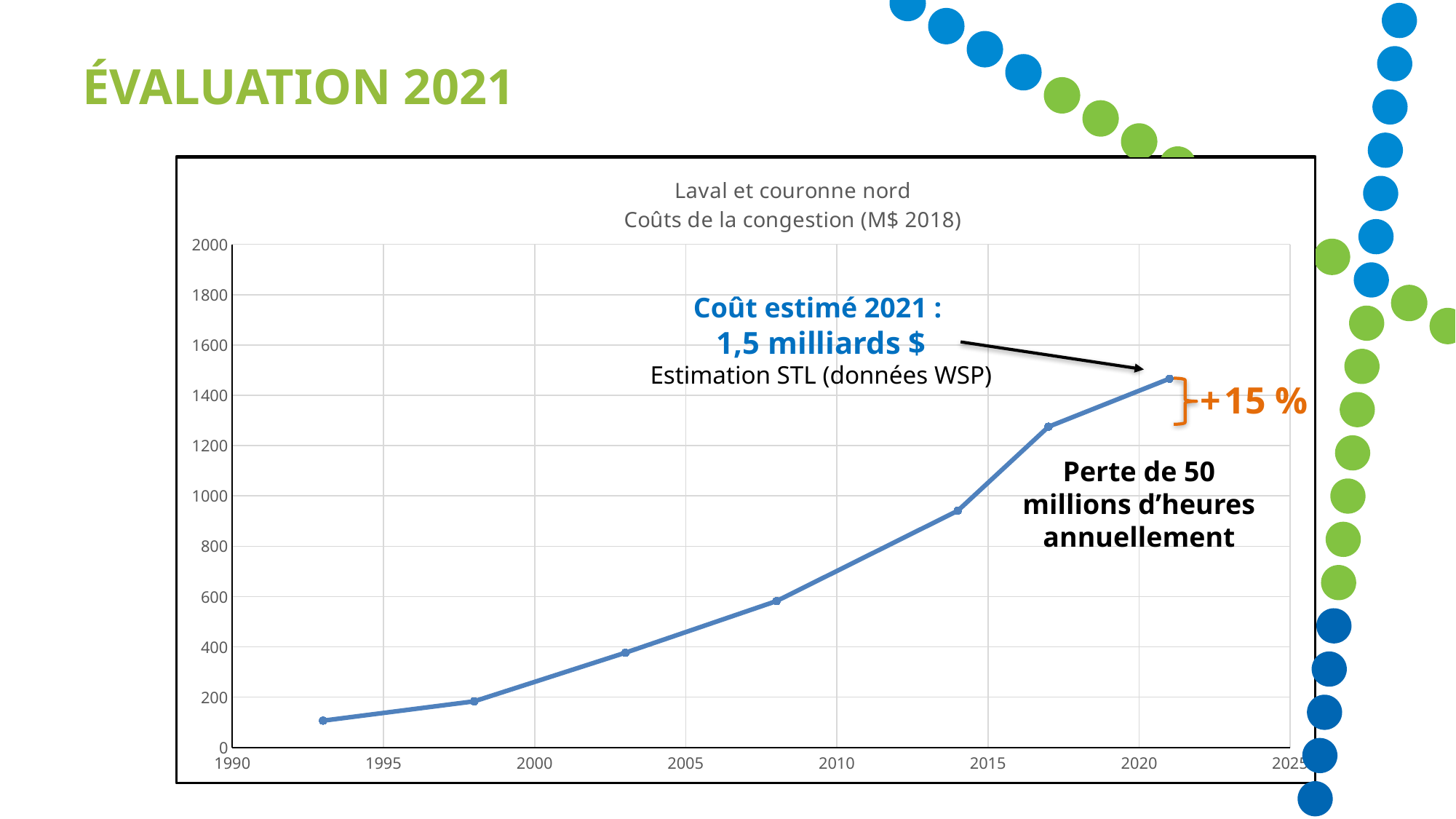
Which year has a higher congestion cost, 2003 or 2014? 2014 Do the congestion costs rise or fall over time along the x axis? rise Is the congestion cost for 2017 greater or less than 1200? greater Which year has the highest congestion cost on the chart? 2021 Which year has the lowest congestion cost on the chart? 1993 Is the congestion cost for 2014 greater or less than 1000? less What kind of chart is shown on the slide? line chart What is the title of the chart? Laval et couronne nord – Coûts de la congestion (M$ 2018) Is the congestion cost for 2008 greater or less than 400? greater What percentage increase is indicated by the orange annotation next to the last point? +15 % According to the annotation, what is the estimated congestion cost for 2021? 1,5 milliards $ How many data points are plotted on the line? 7